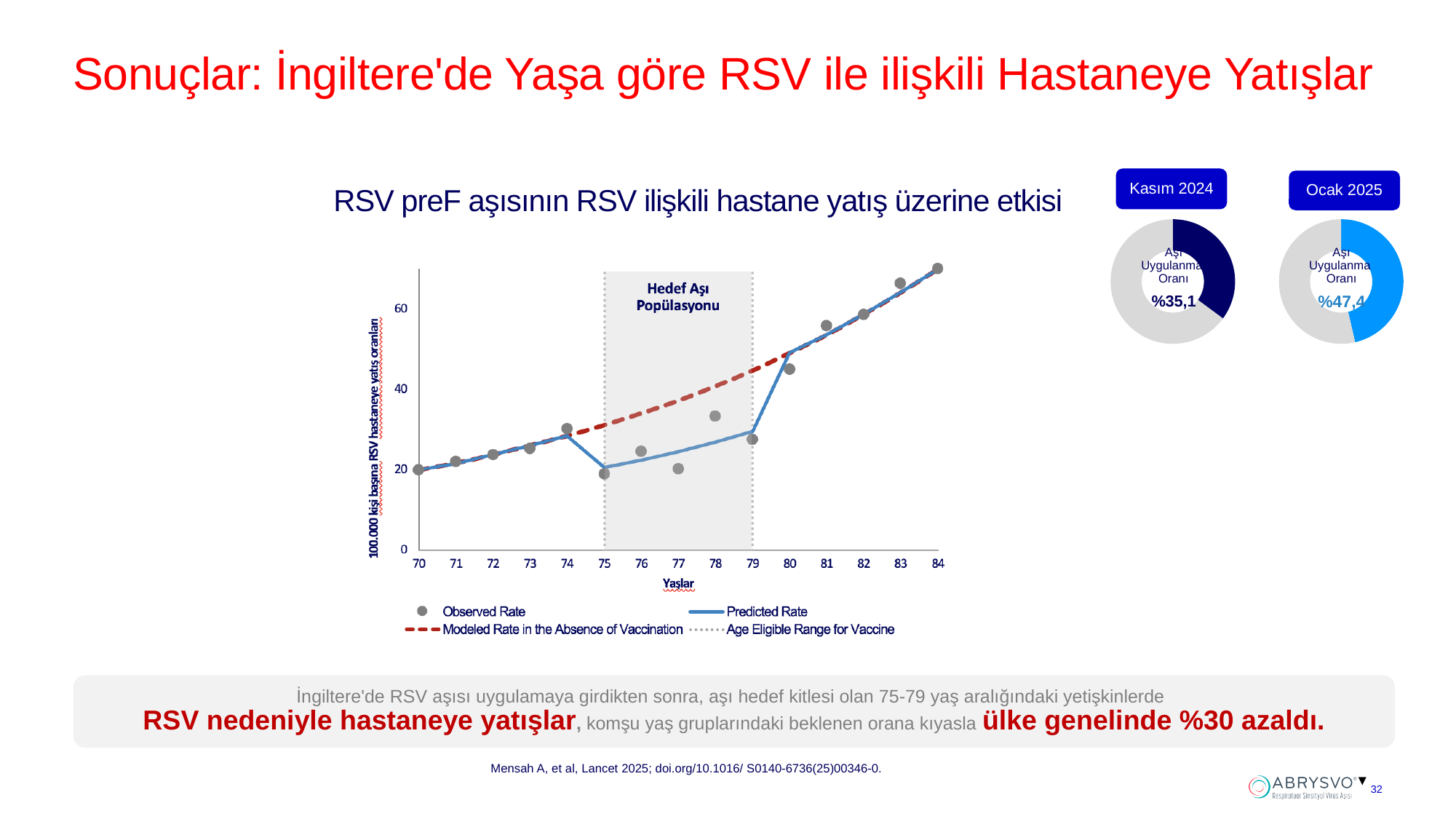
In the main line chart, how many ages are labelled on the x axis (Yaşlar)? 15 In the main line chart, is the Observed Rate at age 84 greater or less than 60? greater By how many percentage points does the Ocak 2025 uptake rate exceed the Kasım 2024 uptake rate in the donut charts? 12,3 In the main line chart, is the Observed Rate at age 77 greater or less than 40? less How many entries does the legend of the main line chart list? 4 In the main line chart, does the Predicted Rate rise or fall between ages 79 and 84? rise In the Kasım 2024 donut chart, what is the vaccine uptake rate (Aşı Uygulanma Oranı) shown? %35,1 Comparing the two donut charts, which month shows the higher vaccine uptake rate, Kasım 2024 or Ocak 2025? Ocak 2025 In the main line chart, at which age is the Observed Rate highest? 84 In the main line chart, what label is printed inside the shaded age range between 75 and 79? Hedef Aşı Popülasyonu In the Ocak 2025 donut chart, what is the vaccine uptake rate (Aşı Uygulanma Oranı) shown? %47,4 What kind of chart is the main chart titled 'RSV preF aşısının RSV ilişkili hastane yatış üzerine etkisi'? line chart